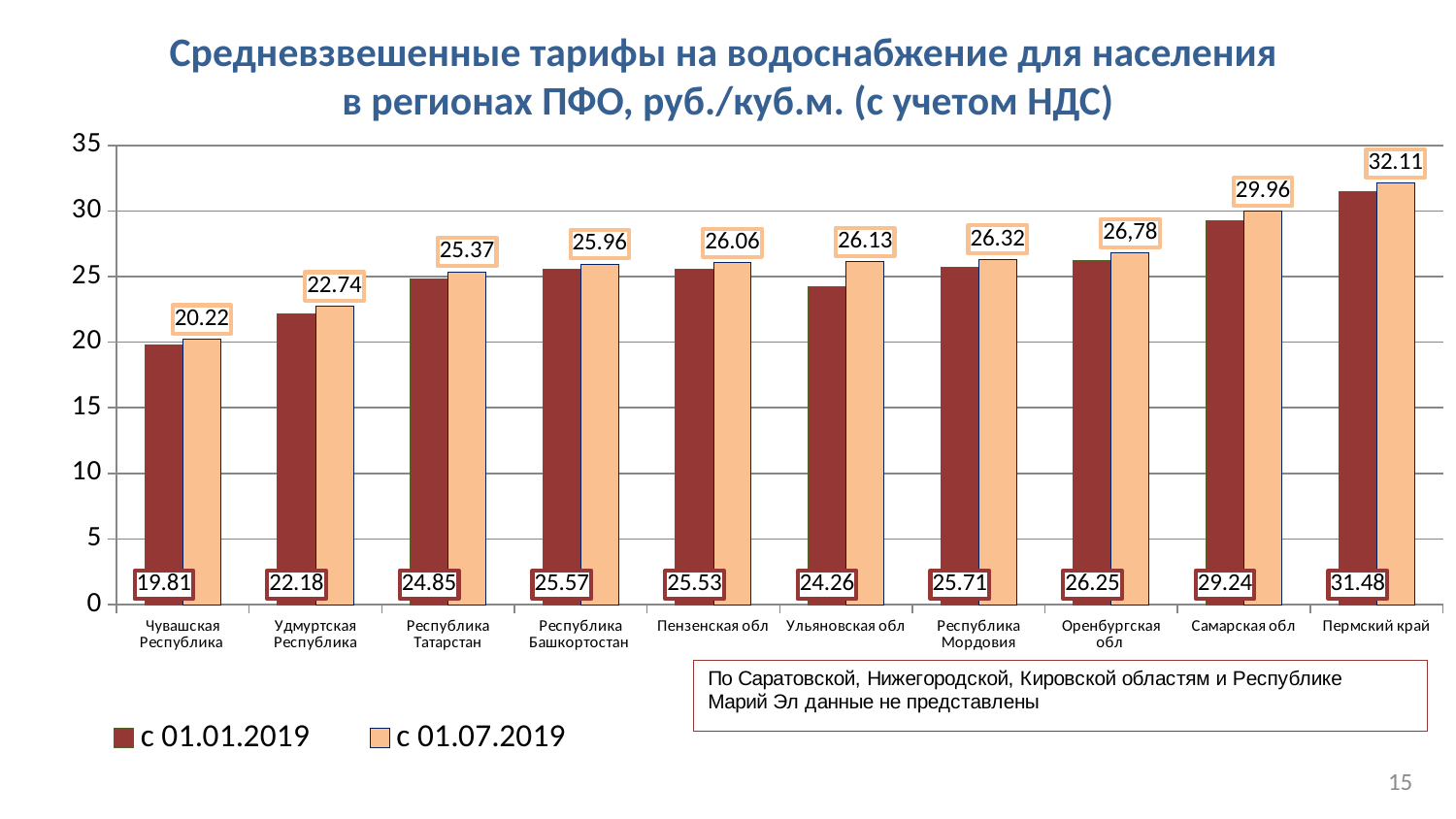
How many series does the legend list? 2 How many regions are shown on the x axis of the chart? 10 Do the с 01.07.2019 values generally rise or fall from left to right along the x axis? rise What is the difference between the с 01.07.2019 and с 01.01.2019 values for Ульяновская обл? 1.87 What is the value for Оренбургская обл in the series с 01.07.2019? 26,78 What is the value for Ульяновская обл in the series с 01.01.2019? 24.26 Which is larger: the с 01.01.2019 value for Республика Татарстан or for Удмуртская Республика? Республика Татарстан What is the difference between the с 01.07.2019 values for Самарская обл and Пермский край? 2.15 Which region has the lowest value in the series с 01.07.2019? Чувашская Республика What is the value for Пермский край in the series с 01.07.2019? 32.11 What kind of chart is shown on the slide? bar chart Which region has the highest value in the series с 01.01.2019? Пермский край